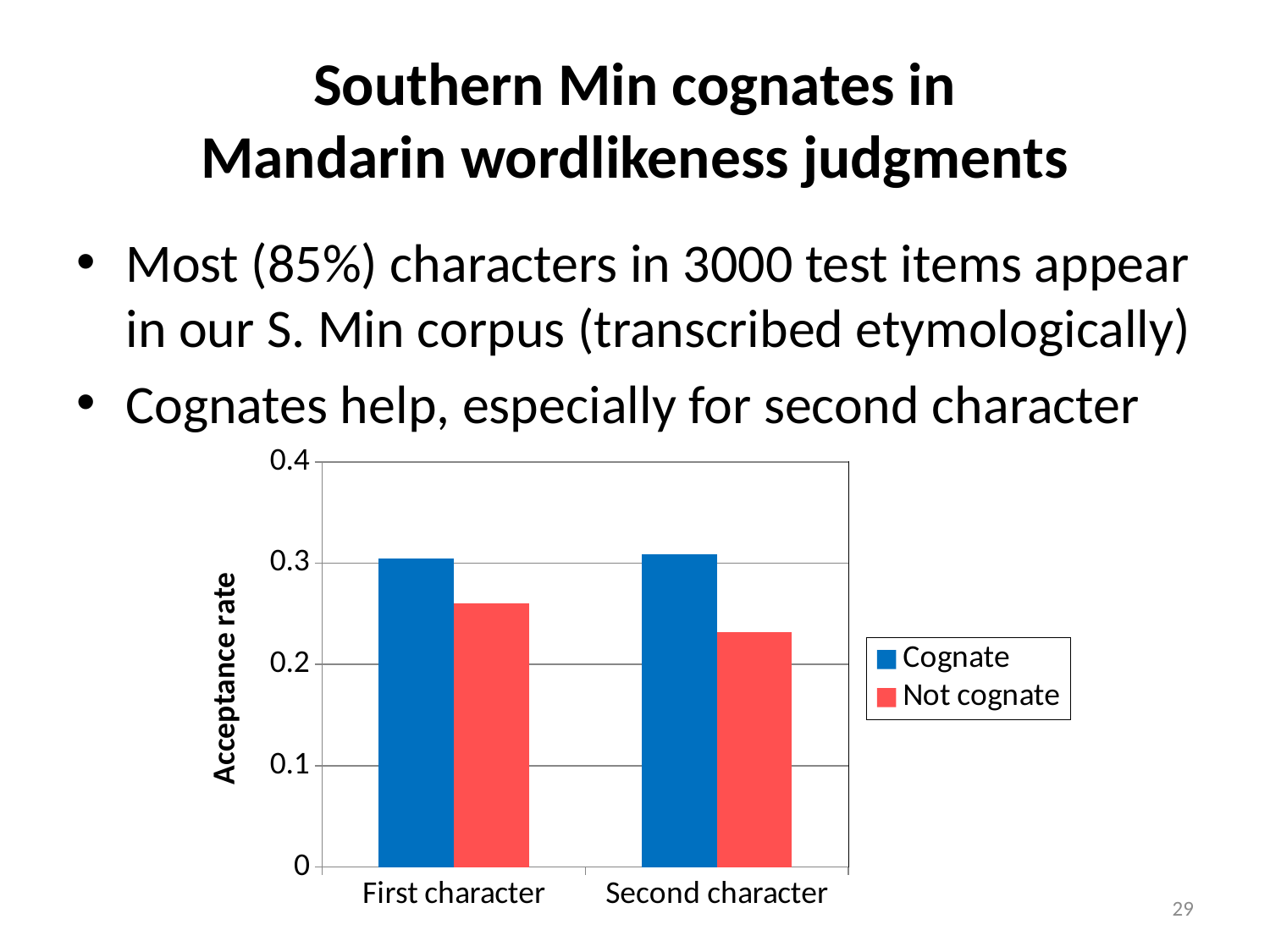
Does the Not cognate acceptance rate rise or fall from First character to Second character? fall For Second character, which is larger: the Cognate or the Not cognate acceptance rate? Cognate For the Not cognate series, which category has the higher acceptance rate: First character or Second character? First character Is the Not cognate acceptance rate for First character greater or less than 0.2? greater For First character, which is larger: the Cognate or the Not cognate acceptance rate? Cognate Is the Not cognate acceptance rate for Second character greater or less than 0.3? less What is the label of the y axis of the chart? Acceptance rate What kind of chart is shown on the slide? bar chart How many series does the chart legend list? 2 How many categories are shown on the x axis of the chart? 2 Which bar in the chart has the lowest acceptance rate? Not cognate, Second character Which series is shown in red in the chart? Not cognate